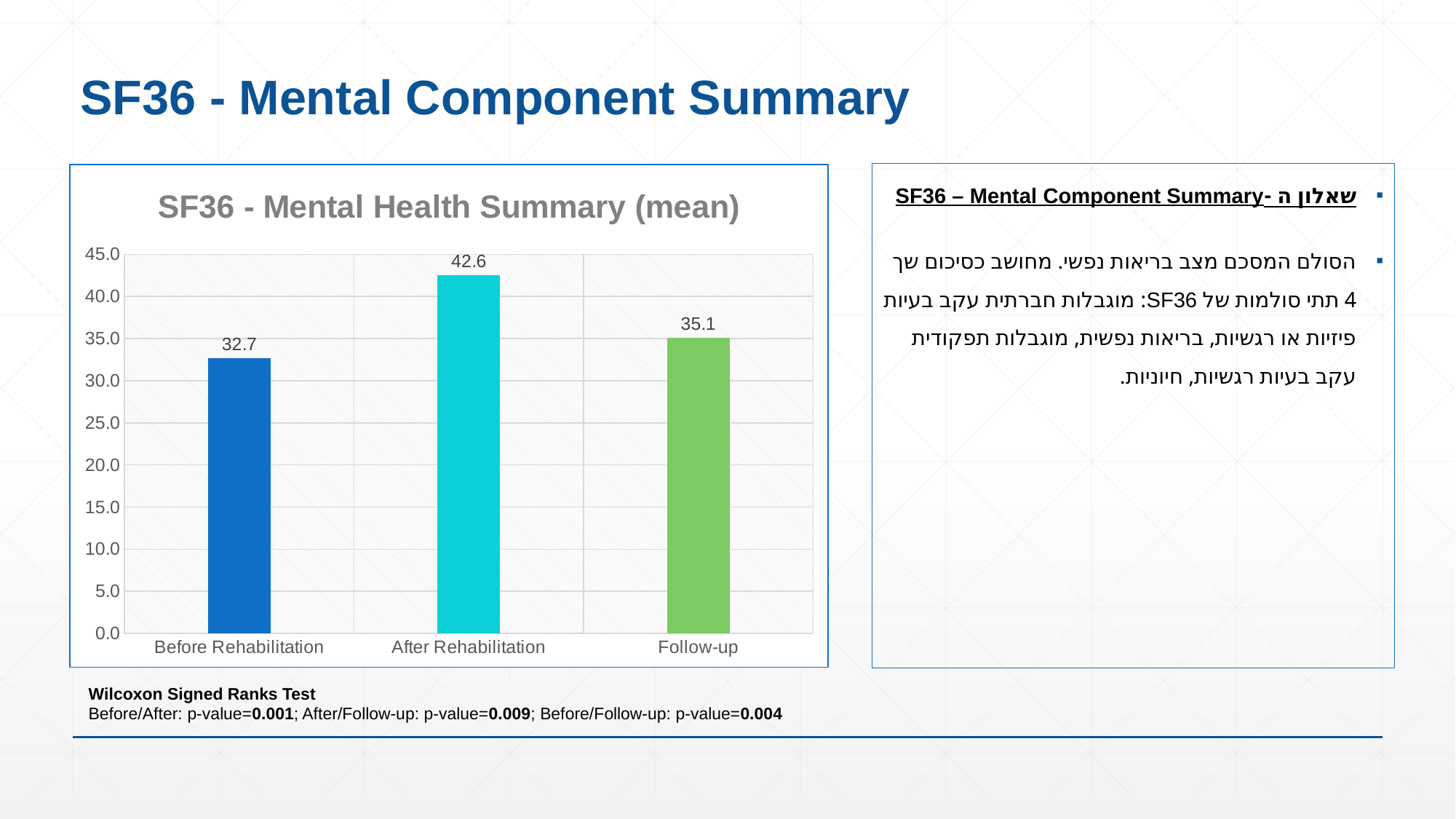
How many categories are shown on the x axis? 3 Is the value for After Rehabilitation greater or less than 40.0? greater What is the title of the chart? SF36 - Mental Health Summary (mean) Which category has the lowest value? Before Rehabilitation What is the difference between the After Rehabilitation and Follow-up values? 7.5 What is the mean value for Follow-up? 35.1 Which category has the highest value? After Rehabilitation Which is larger, the value for Follow-up or the value for Before Rehabilitation? Follow-up What is the mean value for Before Rehabilitation? 32.7 What kind of chart is shown on the slide? bar chart What is the mean value for After Rehabilitation? 42.6 What is the difference between the After Rehabilitation and Before Rehabilitation values? 9.9